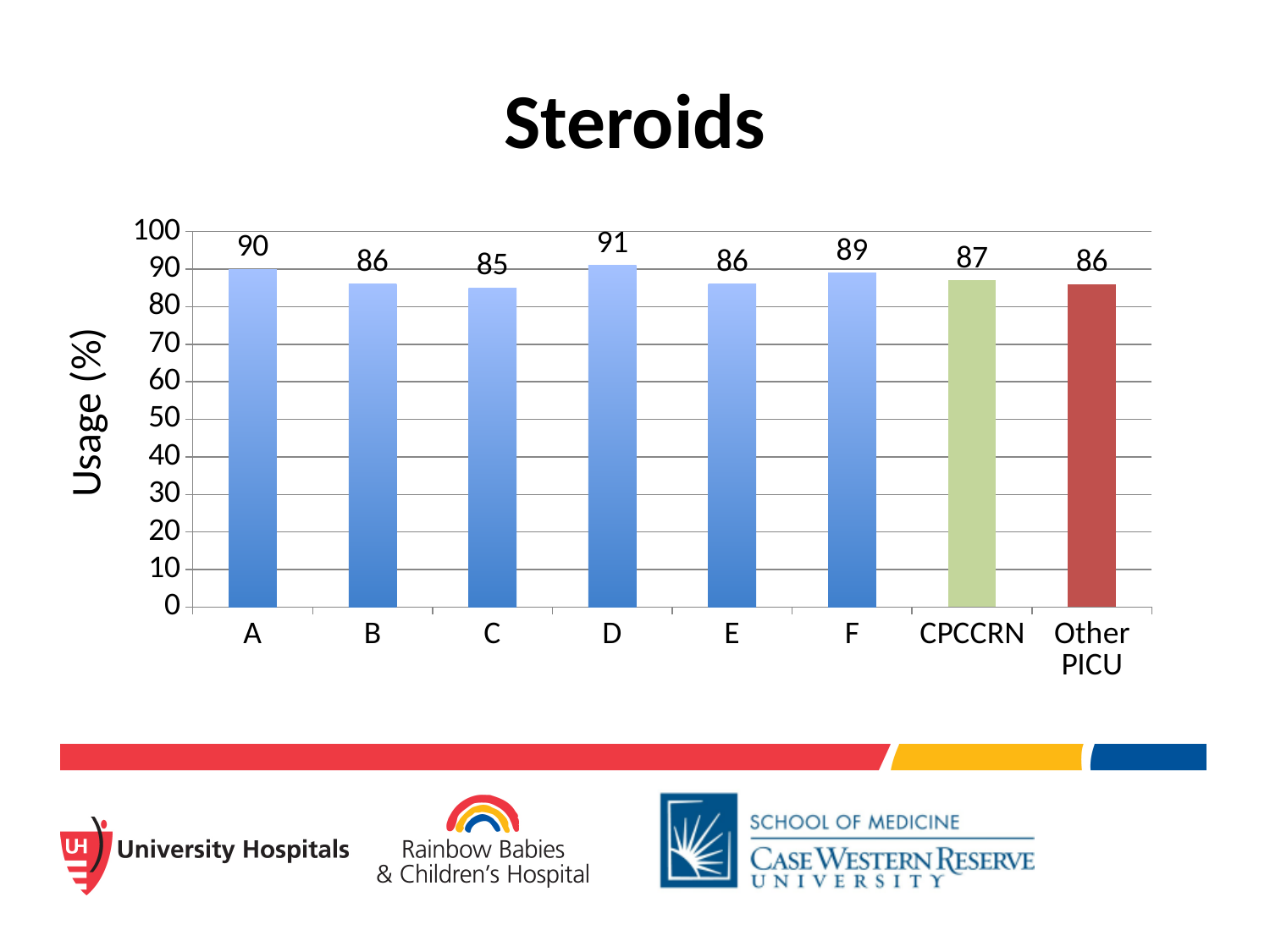
What is the difference in steroid usage between site A and CPCCRN? 3 Which has a higher steroid usage, site F or site B? F What is the steroid usage value for site D? 91 What is the steroid usage value for Other PICU? 86 Which category has the lowest steroid usage? C Is the value for site A greater or less than 80? greater Which category has the highest steroid usage? D How many categories are shown on the x axis? 8 What is the difference in steroid usage between site D and site C? 6 What is the steroid usage value for CPCCRN? 87 What kind of chart is shown on the slide? bar chart What is the label of the y axis? Usage (%)